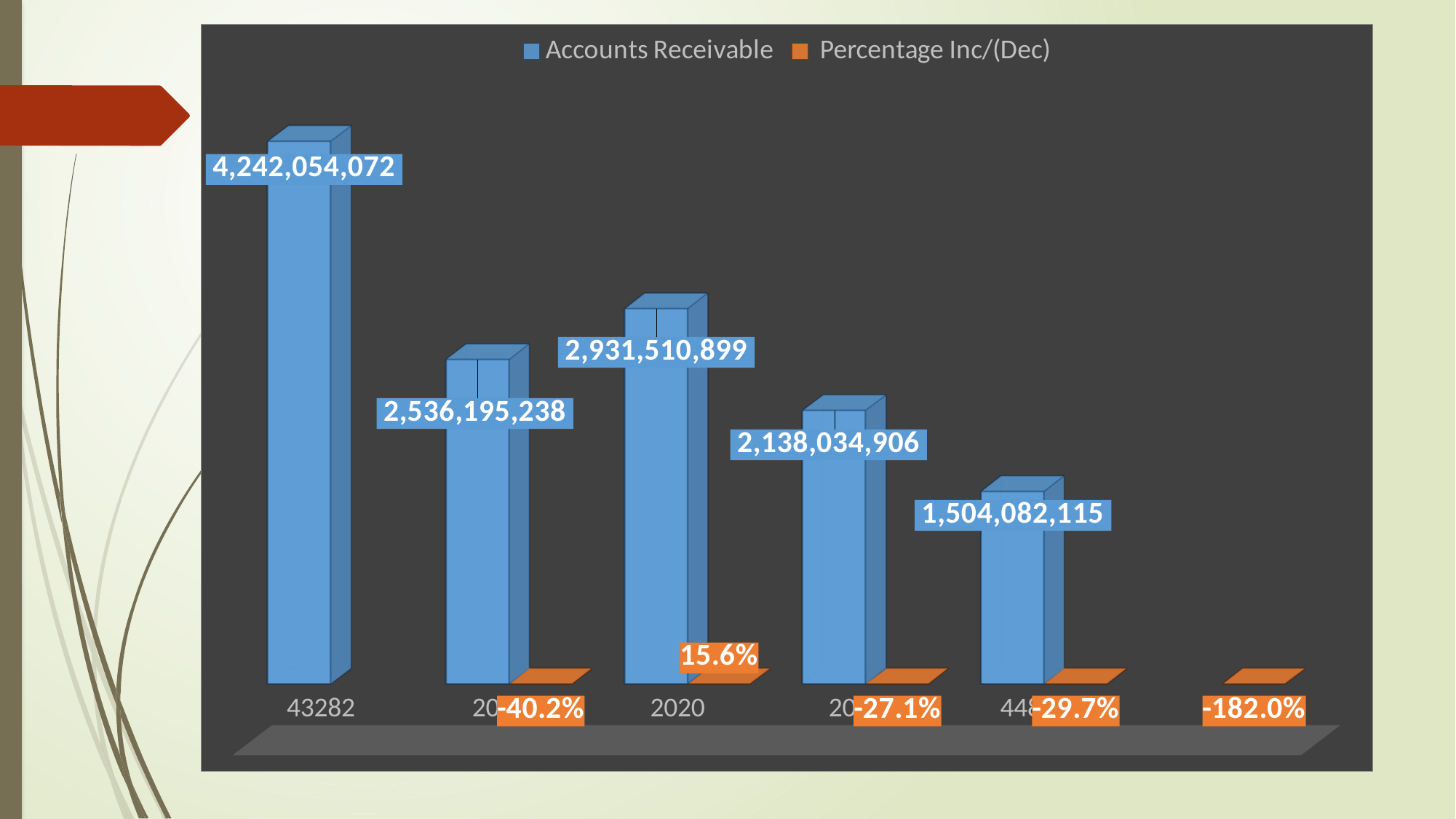
What is the Percentage Inc/(Dec) value for 2020? 15.6% How many series does the legend list? 2 Which has the larger Accounts Receivable value, 43282 or 2020? 43282 What is the Accounts Receivable value for 2020? 2,931,510,899 What is the lowest Percentage Inc/(Dec) value shown on the chart? -182.0% What is the difference between the Accounts Receivable values for 43282 and 2020? 1,310,543,173 What is the highest Percentage Inc/(Dec) value shown on the chart? 15.6% What kind of chart is shown on the slide? Bar chart What is the lowest Accounts Receivable value shown on the chart? 1,504,082,115 Which category has the highest Accounts Receivable value? 43282 Which colour represents the Percentage Inc/(Dec) series in the legend? Orange What is the Accounts Receivable value for the category labelled 43282? 4,242,054,072